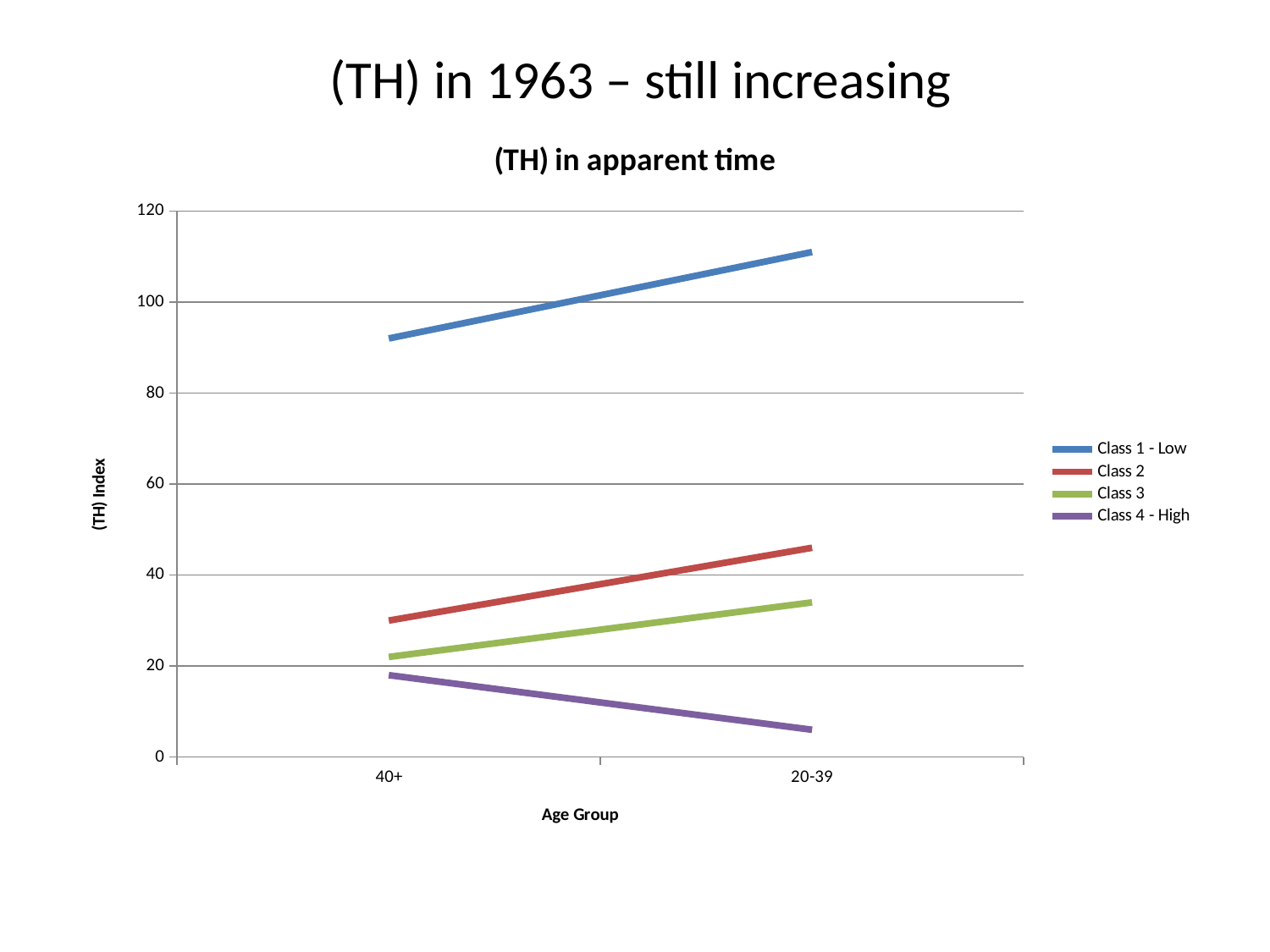
Is the value for Class 2 in the 20-39 age group greater or less than 40? greater Does the value for Class 4 - High rise or fall from the 40+ group to the 20-39 group? fall Which series has the lowest value for the 20-39 age group? Class 4 - High How many series does the legend list? 4 How many age groups are shown on the x axis? 2 Is the value for Class 1 - Low in the 40+ age group greater or less than 100? less Which series has the highest values across both age groups? Class 1 - Low What is the title of the chart? (TH) in apparent time Is the value for Class 1 - Low in the 20-39 age group greater or less than 100? greater Which is larger for the 40+ age group, Class 2 or Class 3? Class 2 What kind of chart is shown on the slide? line chart Does the value for Class 1 - Low rise or fall from the 40+ group to the 20-39 group? rise